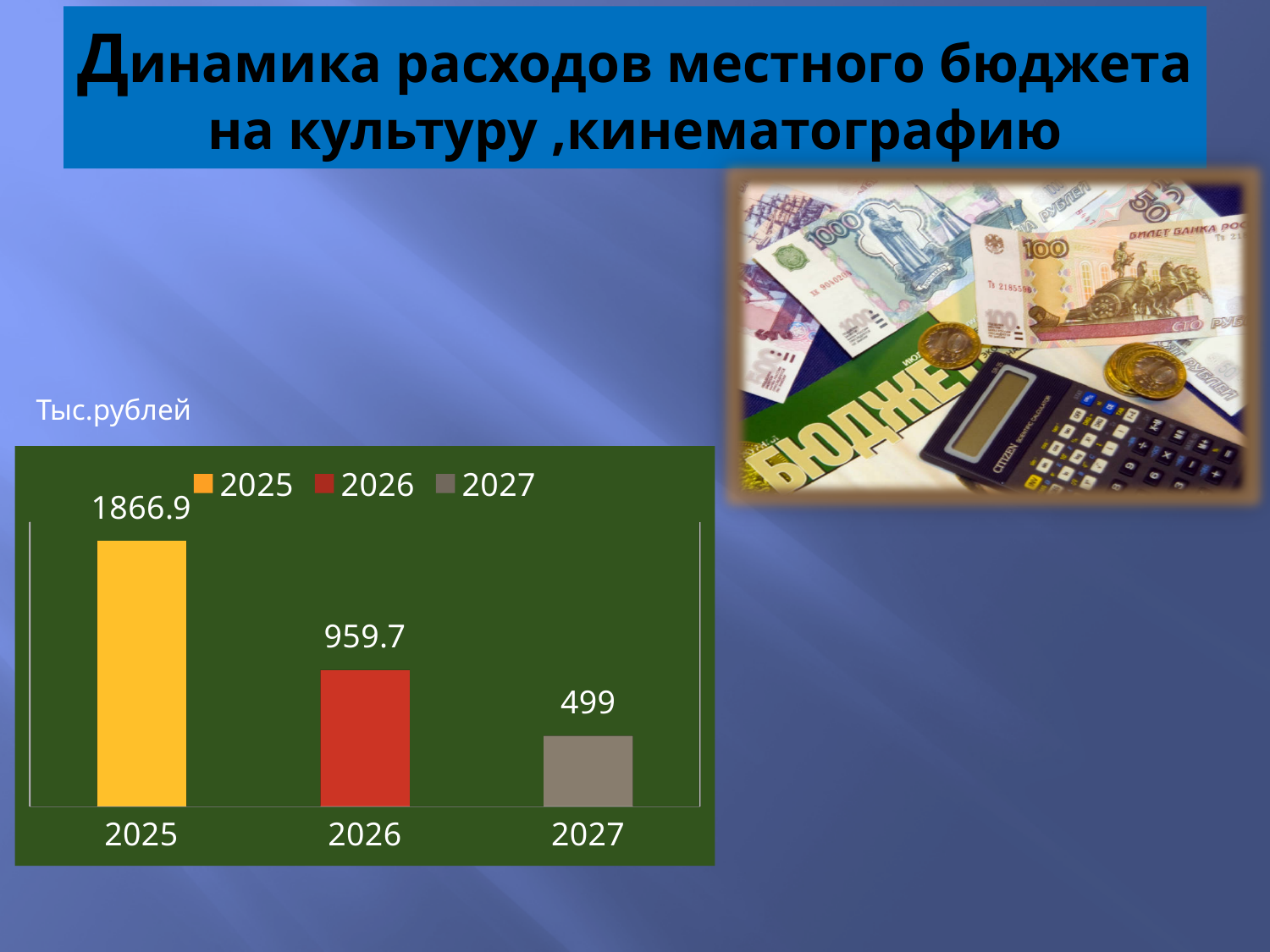
How many years are shown on the chart? 3 What is the difference between the values for 2026 and 2027? 460.7 What is the difference between the values for 2025 and 2026? 907.2 Which year has the lowest value? 2027 What is the value for 2027? 499 What is the value for 2026? 959.7 Which year has the highest value? 2025 What is the value for 2025? 1866.9 Which is larger, the value for 2026 or the value for 2027? 2026 How many entries does the legend list? 3 Do the values rise or fall from 2025 to 2027? fall What kind of chart is shown? bar chart